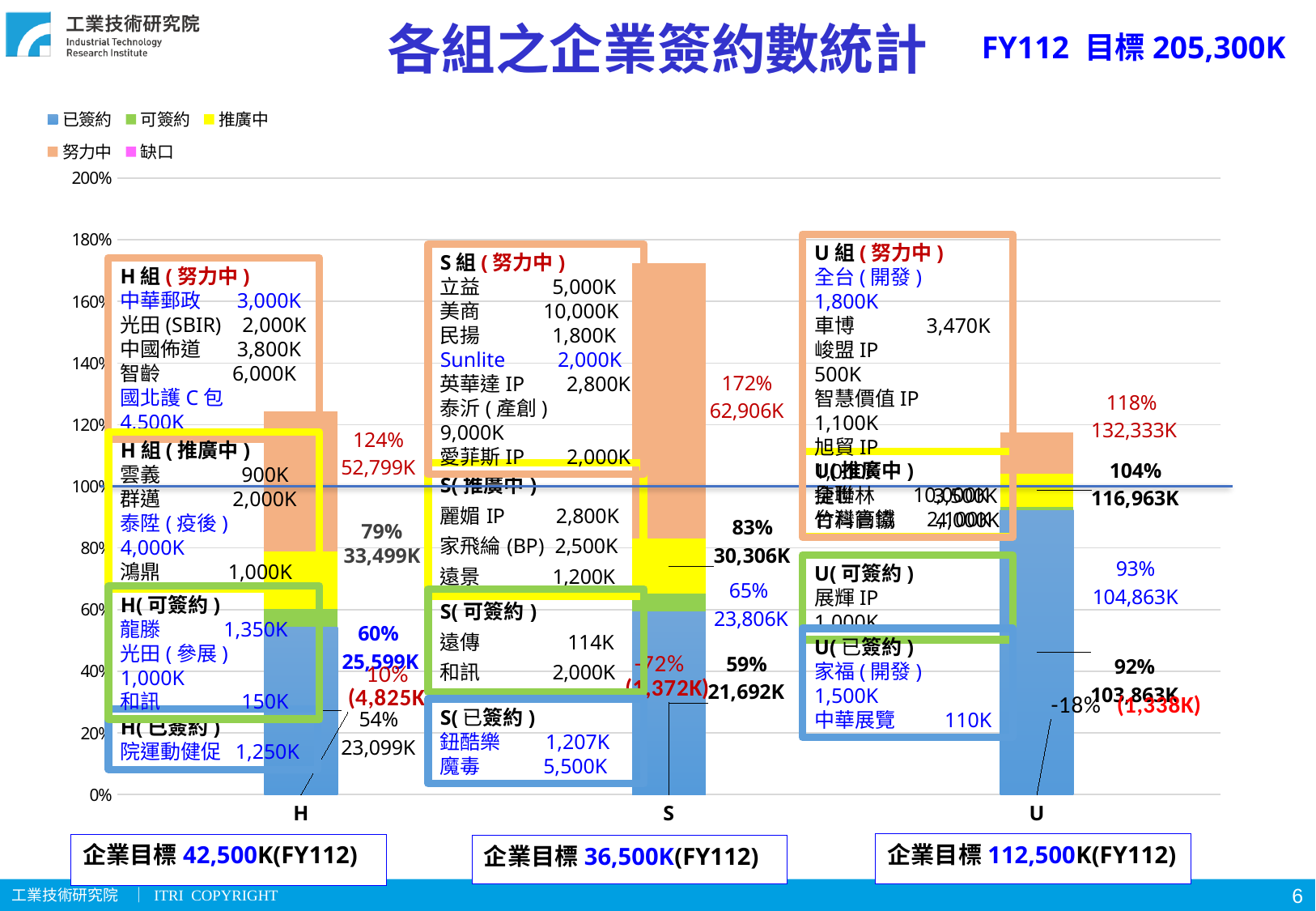
How many categories (groups) are plotted along the x axis? 3 How many series does the chart legend list? 5 What is the 企業目標 (FY112) shown below group U? 112,500K(FY112) Is the 已簽約 percentage for group S greater or less than 80%? less What percentage label is shown for the 已簽約 level of group H? 54% What kind of chart is shown on the slide? stacked bar chart Which group has the highest percentage label at the top of its 努力中 segment? S Which is larger, the 已簽約 percentage label for group H or for group U? U What percentage label is shown at the top of the 努力中 segment for group S? 172% Which group has the lowest percentage label at the top of its 努力中 segment? U What value in K is shown next to the 92% label for group U? 103,863K What value in K is shown next to the 124% label for group H? 52,799K